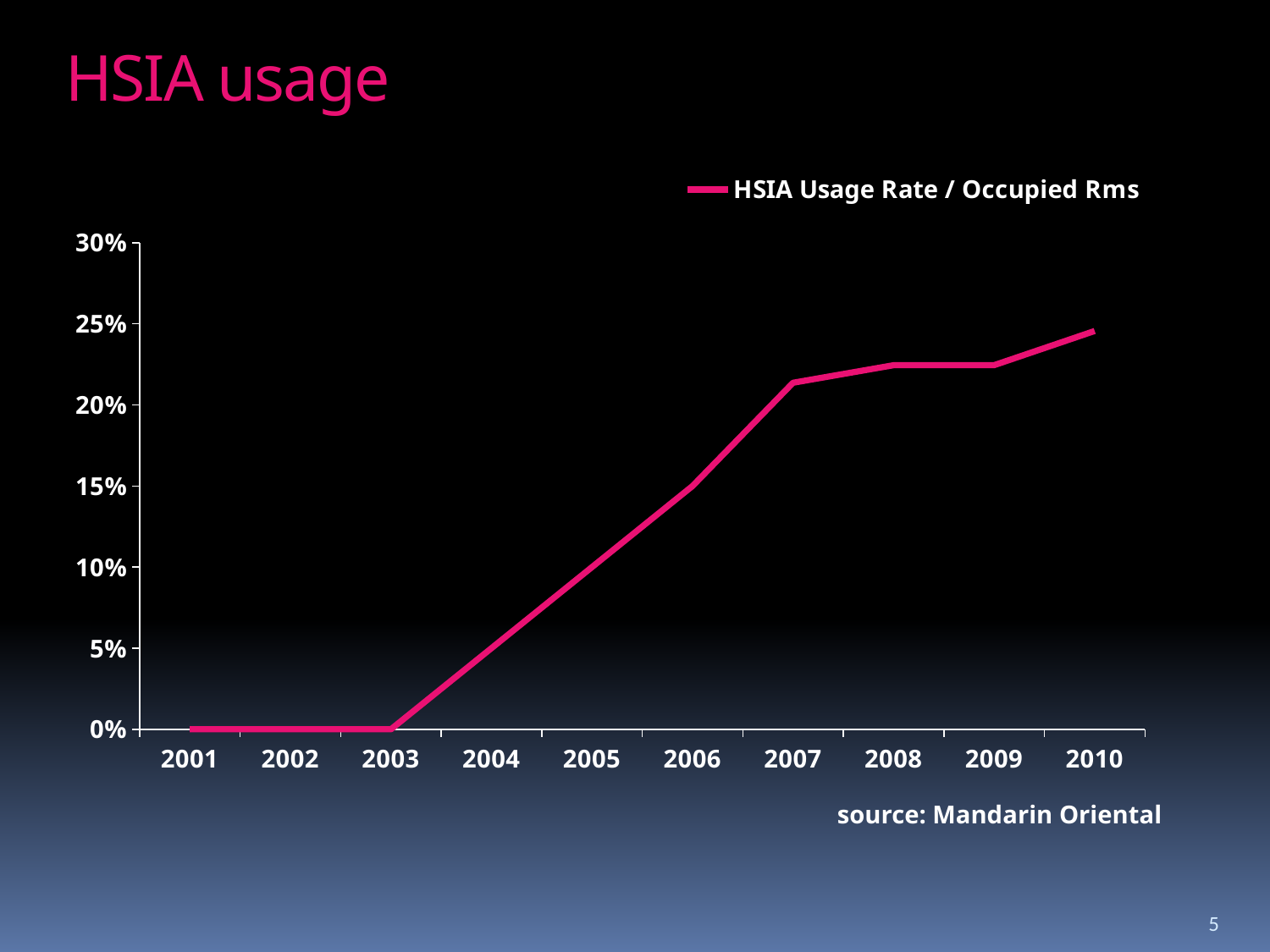
How many series does the legend list? 1 What is the HSIA usage rate for 2001? 0% Which year has the larger HSIA usage rate, 2004 or 2006? 2006 Which year has the highest HSIA usage rate? 2010 Is the value for 2004 greater or less than 10%? less Is the value for 2007 greater or less than 20%? greater What is the name of the series shown in the legend? HSIA Usage Rate / Occupied Rms What kind of chart is shown on the slide? line chart Do the values generally rise or fall from 2003 to 2010? rise Is the value for 2010 greater or less than 25%? less How many years are shown on the x axis? 10